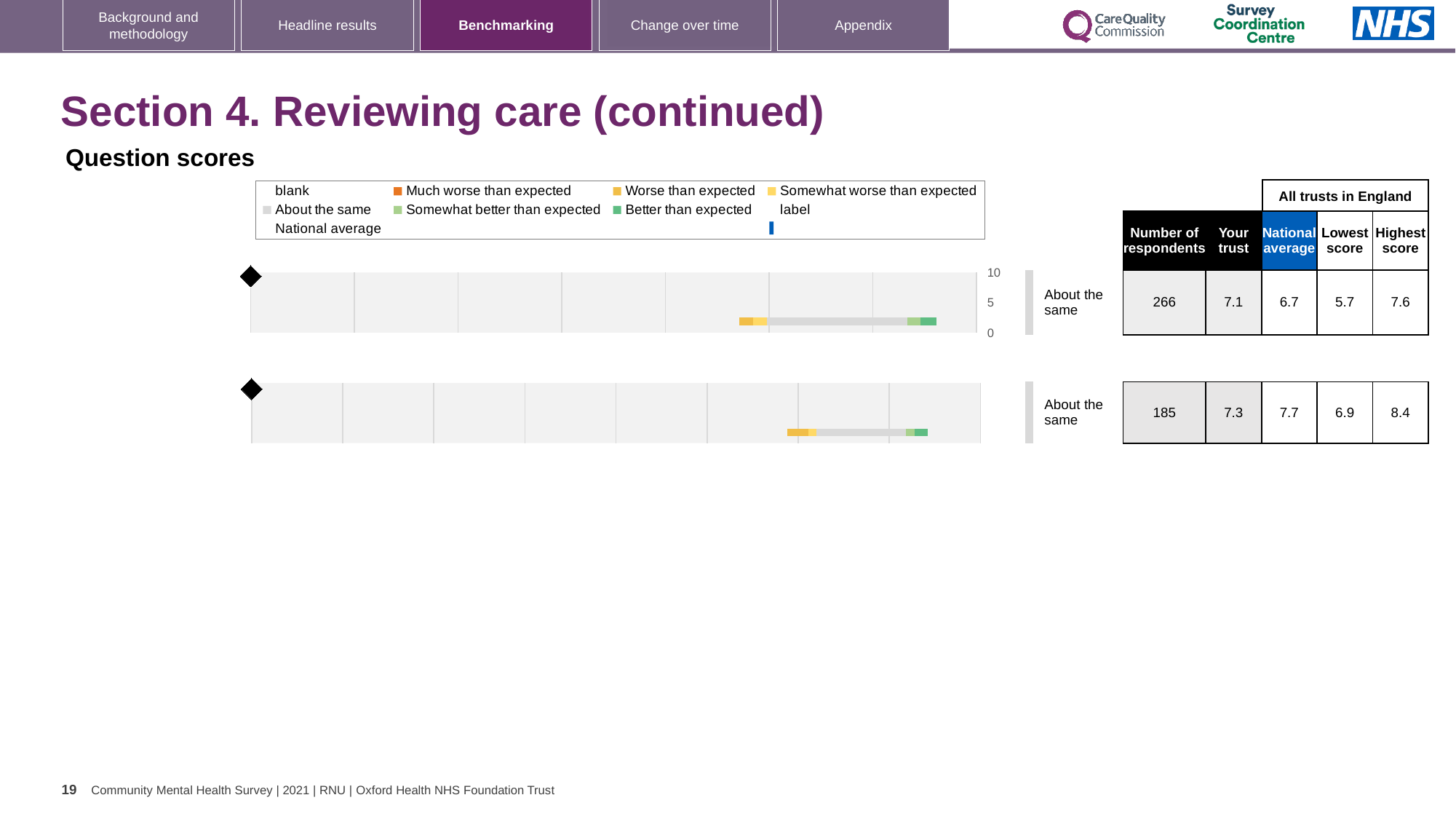
What kind of chart is used to show the question scores on this slide? bar chart For the top chart, what is the 'Your trust' score? 7.1 How many question score charts are shown on the slide? 2 For the bottom chart, what is the difference between the highest score and the lowest score across all trusts in England? 1.5 For the top chart, what is the national average score? 6.7 What is the highest value shown on the vertical axis of the top chart? 10 For the top chart, which is larger: the 'Your trust' score or the national average? Your trust What benchmarking category is given for the top chart? About the same For the bottom chart, which is larger: the 'Your trust' score or the national average? National average For the bottom chart, what is the 'Your trust' score? 7.3 For the bottom chart, what is the number of respondents? 185 For the top chart, what is the number of respondents? 266